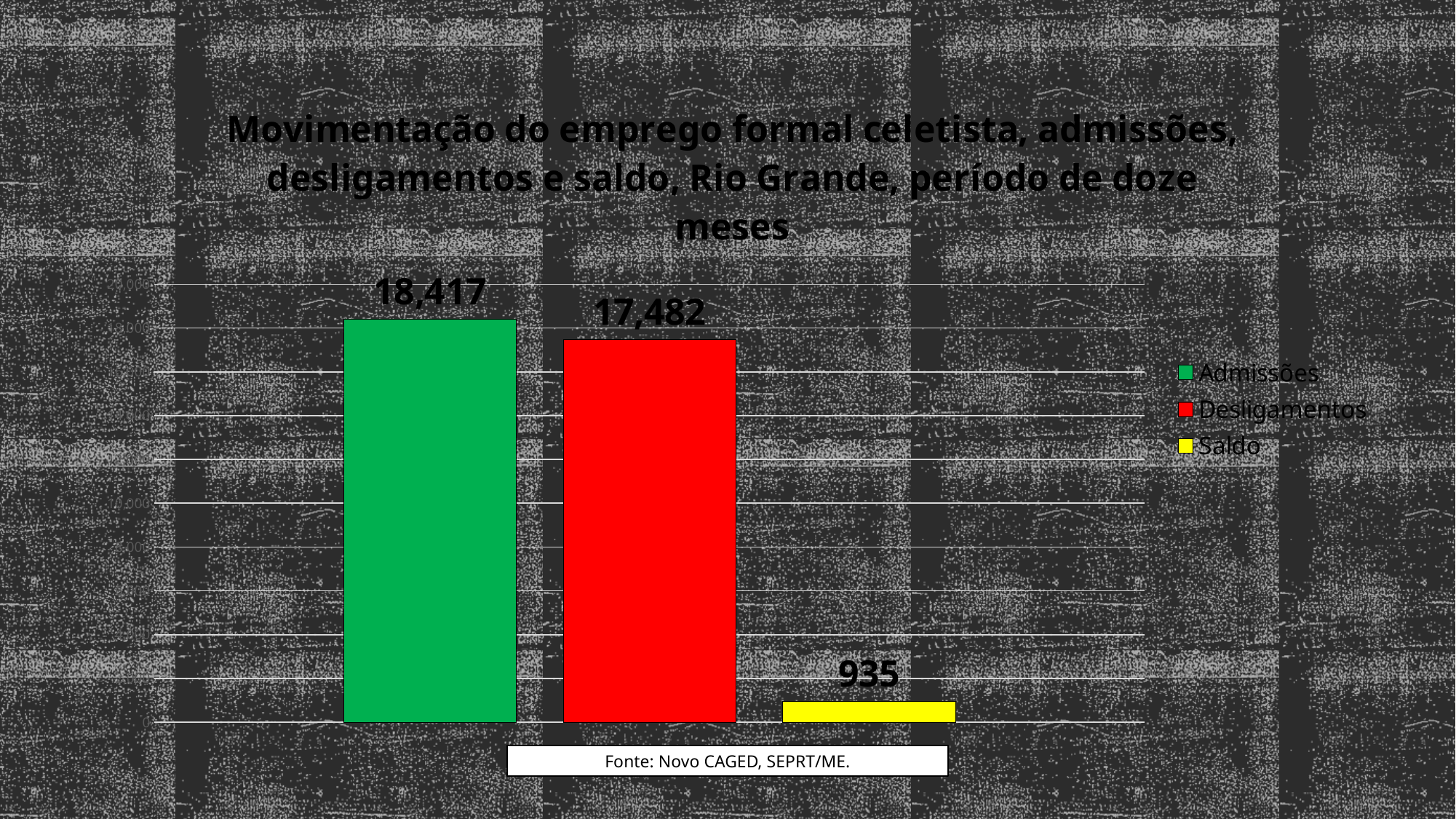
What kind of chart is shown on the slide? Bar chart What is the value shown for Saldo? 935 How many bars are plotted in the chart? 3 What is the value shown for Desligamentos? 17,482 Which is larger, Admissões or Desligamentos? Admissões What colour is the bar for Saldo? Yellow What is the difference between Admissões and Desligamentos? 935 How many series does the legend list? 3 What is the value shown for Admissões? 18,417 Which series has the highest value? Admissões Which is larger, Desligamentos or Saldo? Desligamentos Which series has the lowest value? Saldo